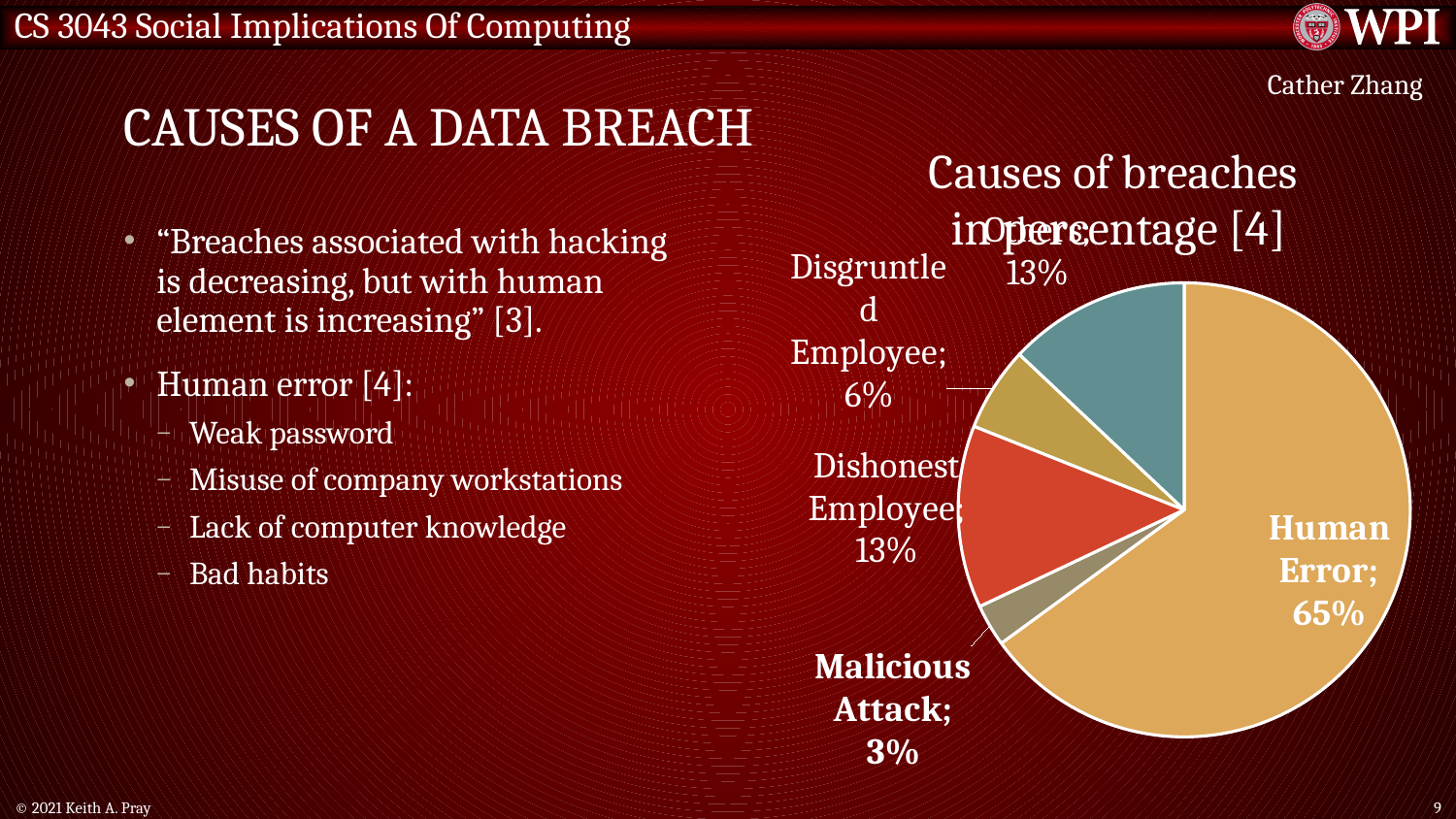
What is the difference in percentage points between Disgruntled Employee and Malicious Attack? 3 Which cause has the smallest share of breaches? Malicious Attack How many slices does the pie chart have? 5 What kind of chart is shown on the slide? pie chart What percentage of breaches is attributed to Human Error? 65% What is the difference in percentage points between Human Error and Dishonest Employee? 52 Which is larger, the share for Disgruntled Employee or the share for Dishonest Employee? Dishonest Employee Which cause has the largest share of breaches? Human Error What is the title of the chart? Causes of breaches in percentage [4] What percentage of breaches is attributed to Disgruntled Employee? 6% What percentage of breaches is attributed to Malicious Attack? 3% What percentage of breaches is attributed to Dishonest Employee? 13%